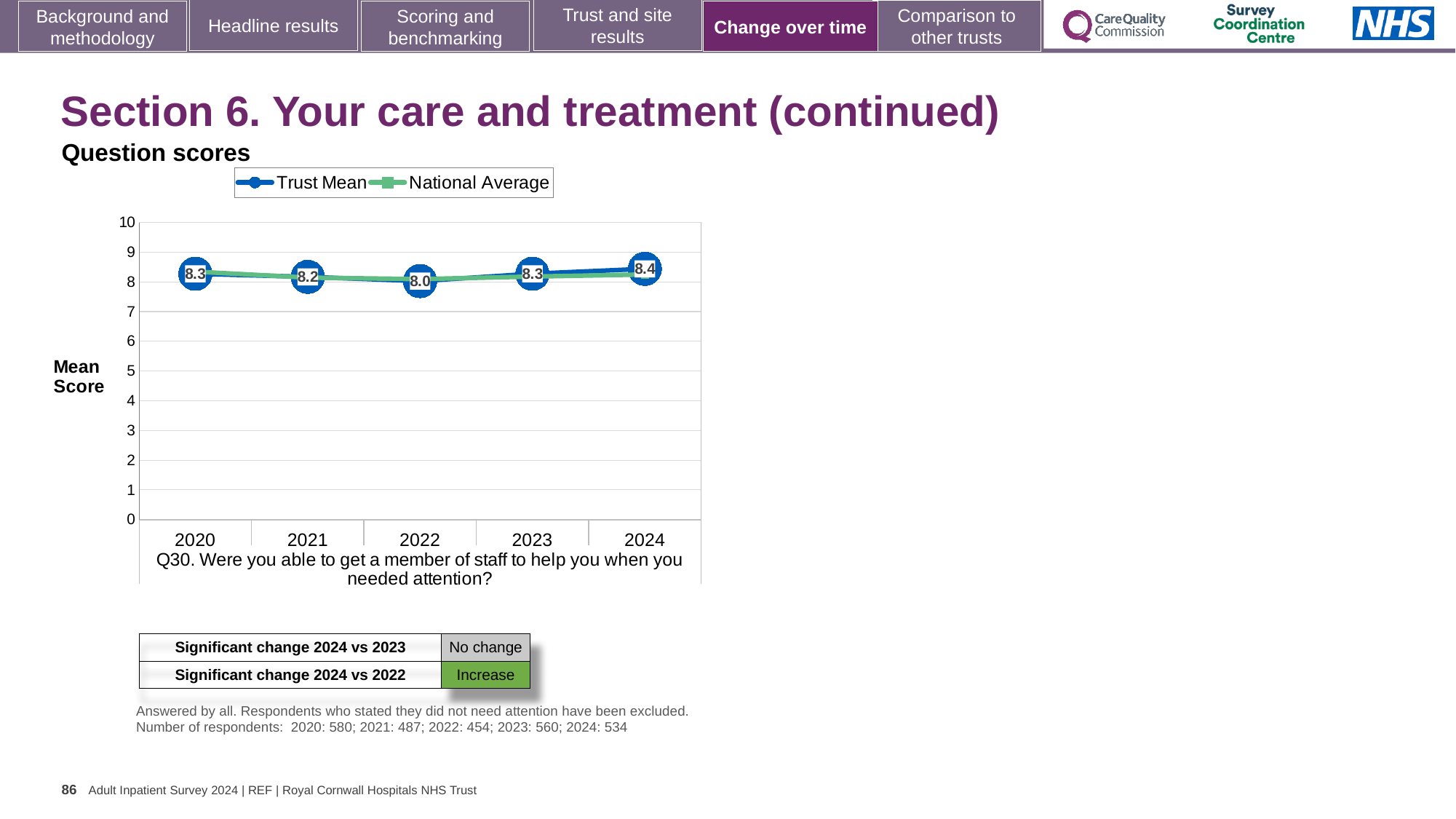
Is the National Average value for 2022 greater or less than 7? greater In which year is the Trust Mean score lowest? 2022 Does the Trust Mean score rise or fall from 2022 to 2024? Rise What is the Trust Mean score for 2022? 8.0 Which year has the larger Trust Mean score, 2020 or 2021? 2020 In which year is the Trust Mean score highest? 2024 How many years are plotted on the x axis of the chart? 5 What is the difference between the Trust Mean score in 2024 and in 2022? 0.4 What is the Trust Mean score for 2024? 8.4 What is the Trust Mean score for 2020? 8.3 How many series does the chart legend list? 2 What kind of chart is shown on the slide? Line chart